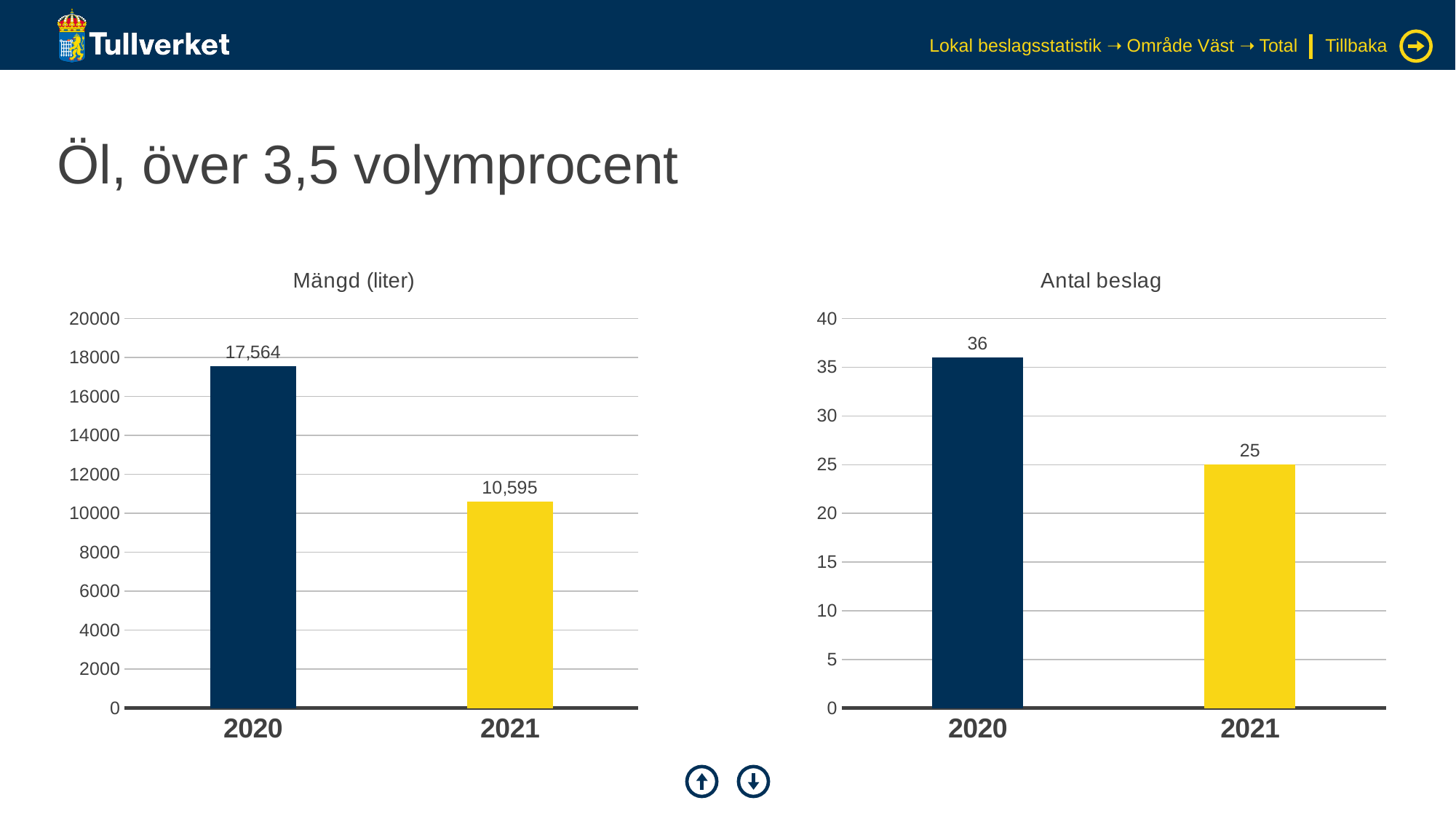
In the 'Antal beslag' chart, what is the value for 2020? 36 In the 'Mängd (liter)' chart, how many years are shown on the x axis? 2 In the 'Antal beslag' chart, which year has the lowest value? 2021 In the 'Antal beslag' chart, is the value for 2020 larger or smaller than the value for 2021? larger In the 'Mängd (liter)' chart, what is the value for 2020? 17,564 What kind of chart is the 'Antal beslag' chart? bar chart In the 'Mängd (liter)' chart, what is the value for 2021? 10,595 In the 'Mängd (liter)' chart, which year has the highest value? 2020 In the 'Antal beslag' chart, what is the value for 2021? 25 In the 'Antal beslag' chart, what is the difference between the 2020 and 2021 values? 11 In the 'Mängd (liter)' chart, what is the difference between the 2020 and 2021 values? 6,969 In the 'Mängd (liter)' chart, do the values rise or fall from 2020 to 2021? fall